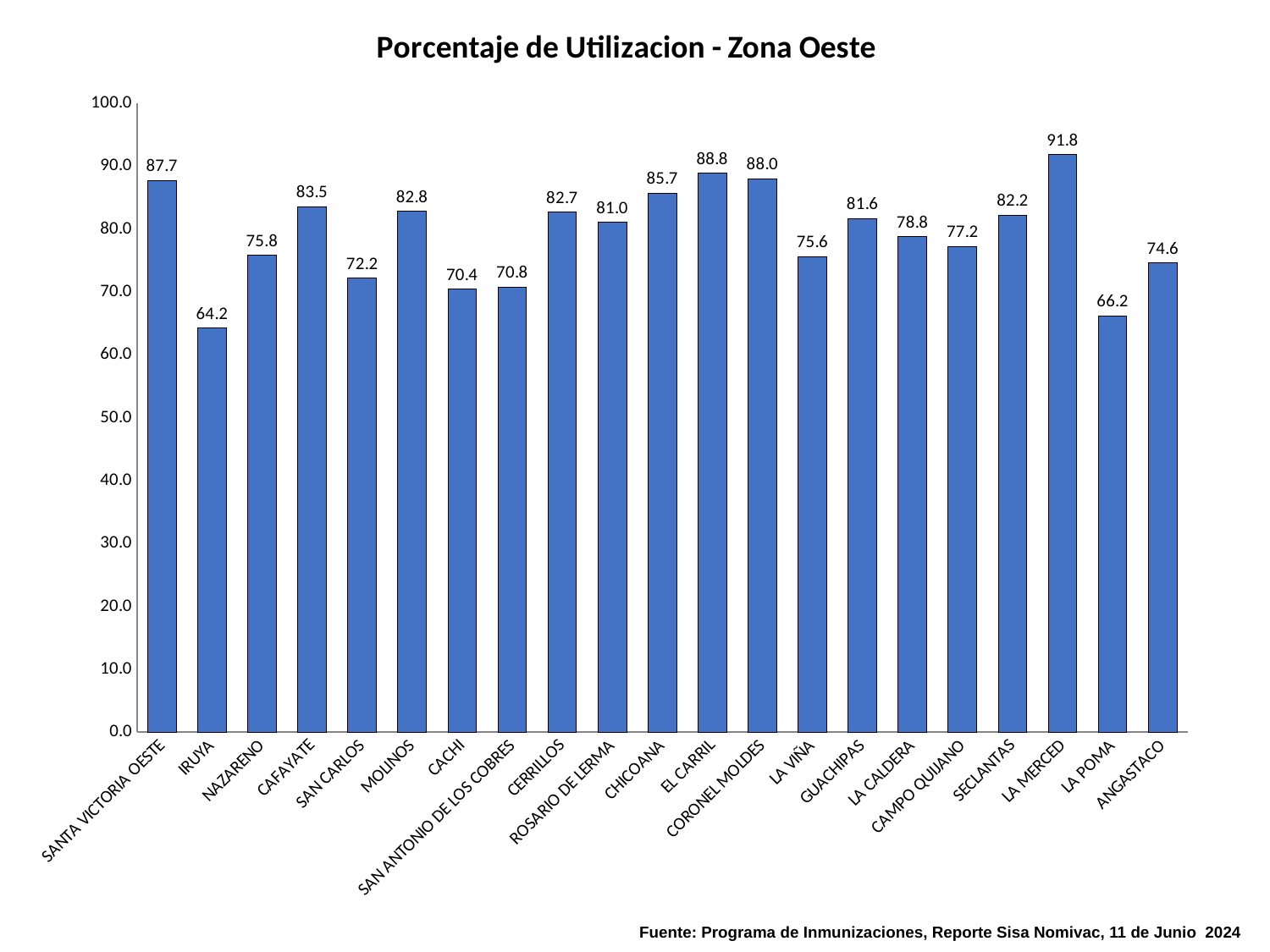
What is the value for CAFAYATE? 83.5 Is the value for LA POMA greater or less than 70.0? less How many categories are shown on the x axis? 21 What is the difference between the values for CAFAYATE and NAZARENO? 7.7 Which category has the lowest value? IRUYA What is the difference between the values for LA MERCED and IRUYA? 27.6 What kind of chart is shown on the slide? bar chart What is the value for CAMPO QUIJANO? 77.2 What is the value for SAN ANTONIO DE LOS COBRES? 70.8 Which category has the highest value? LA MERCED What is the title of the chart? Porcentaje de Utilizacion - Zona Oeste Which is larger, the value for CHICOANA or the value for SECLANTAS? CHICOANA